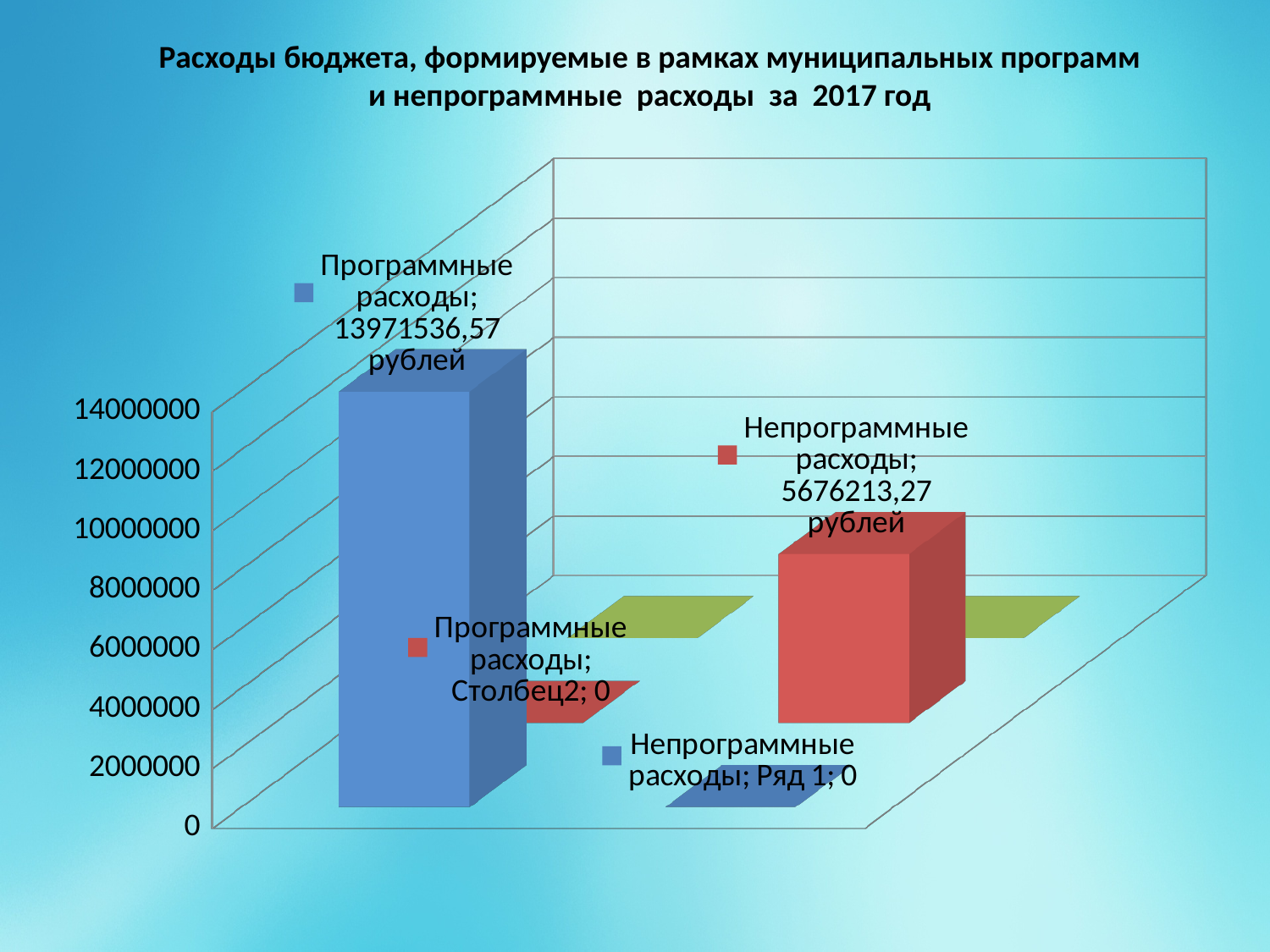
What is the value shown for Непрограммные расходы? 5676213,27 рублей What is the difference between Программные расходы (13971536,57) and Непрограммные расходы (5676213,27)? 8295323,30 Is the value for Программные расходы larger or smaller than the value for Непрограммные расходы? larger Is the value for Непрограммные расходы greater or less than 8000000? less What kind of chart is shown on the slide? bar chart What is the highest tick value shown on the vertical axis? 14000000 What value is labelled for Программные расходы; Столбец2? 0 Which of the two main categories has the lowest value? Непрограммные расходы What is the value shown for Программные расходы? 13971536,57 рублей Which category has the highest value, Программные расходы or Непрограммные расходы? Программные расходы What year does the chart title say the expenses are for? 2017 Is the value for Программные расходы greater or less than 12000000? greater